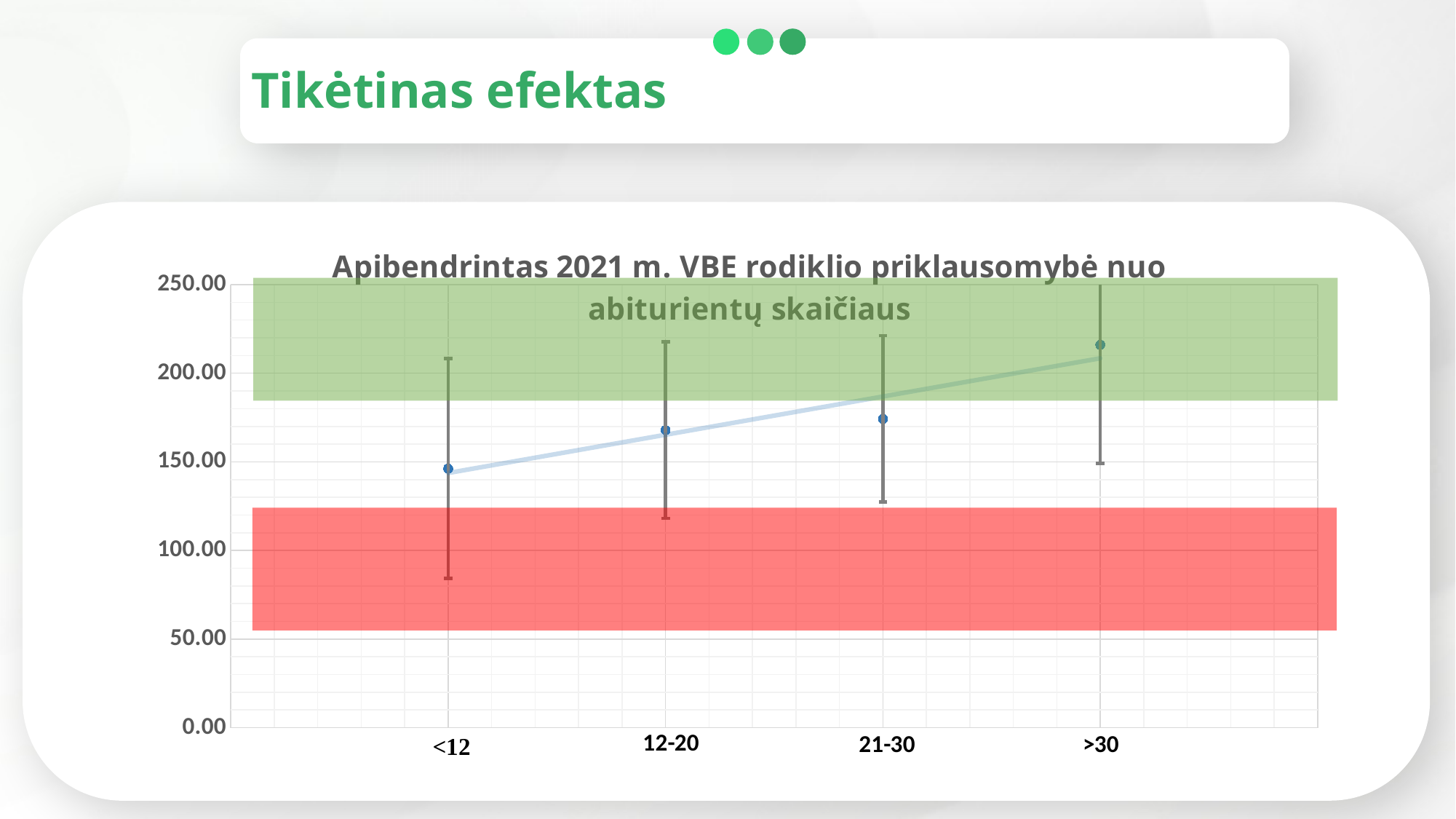
Which category has the highest plotted value? >30 Is the plotted value for 12-20 greater or less than 150? greater Is the plotted value for 21-30 greater or less than 200? less Is the plotted value for <12 greater or less than 100? greater What kind of chart is shown on the slide? line chart Which category has the lowest plotted value? <12 How many categories are plotted along the x axis? 4 What is the title of the chart? Apibendrintas 2021 m. VBE rodiklio priklausomybė nuo abiturientų skaičiaus Which has the larger plotted value, 12-20 or >30? >30 Do the plotted values rise or fall from <12 to >30? rise Which has the larger plotted value, <12 or >30? >30